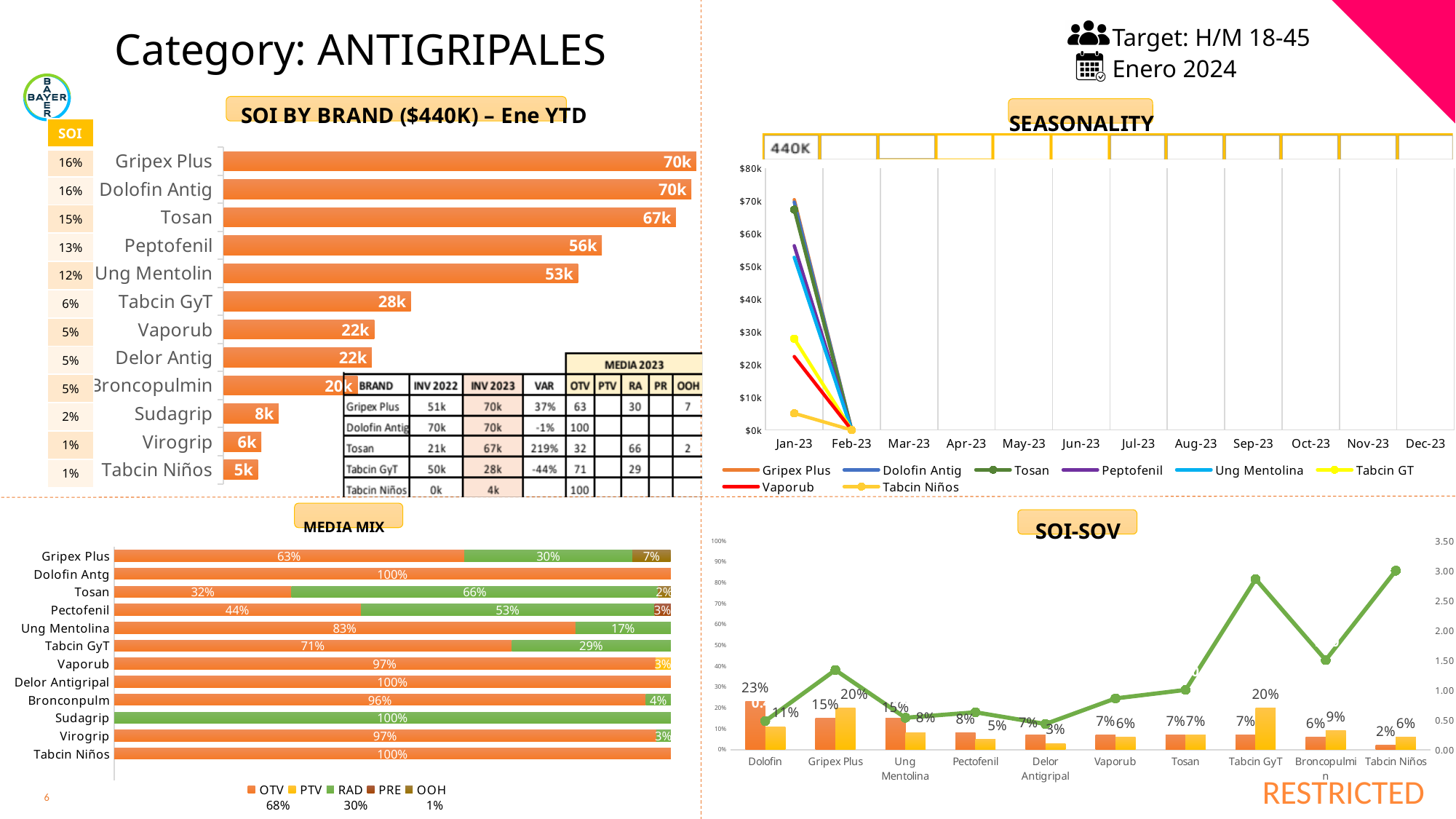
In the SEASONALITY chart, is the Jan-23 value for Tosan greater or less than $60k? greater In the SOI BY BRAND chart, which brand has the lowest value? Tabcin Niños In the SOI BY BRAND chart, how many brands are shown? 12 In the MEDIA MIX chart, what share of Tosan's media mix is RAD? 66% In the SOI BY BRAND chart, what is the value for Peptofenil? 56k What kind of chart is the SEASONALITY chart? Line chart How many series does the legend of the SEASONALITY chart list? 8 In the SOI-SOV chart, which is larger for Tabcin GyT: the orange bar or the yellow bar? The yellow bar (20%) In the SOI BY BRAND chart, what is the value for Tabcin GyT? 28k In the MEDIA MIX chart, how many media types does the legend list? 5 In the SOI BY BRAND chart, what is the difference between Tosan and Vaporub? 45k In the SOI-SOV chart, what is the SOI (orange bar) value for Dolofin? 23%